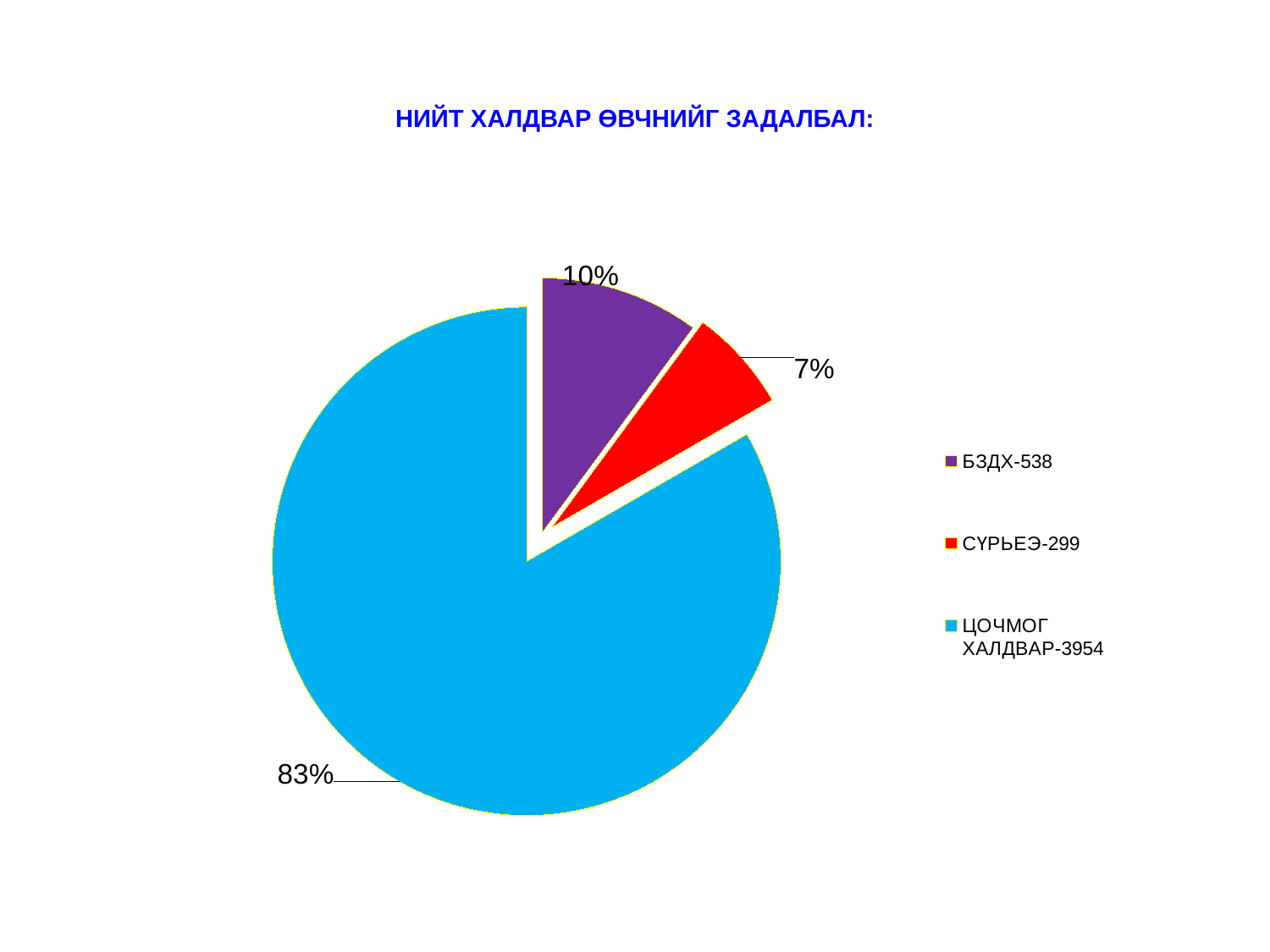
Which is larger, the share for БЗДХ-538 or the share for СҮРЬЕЭ-299? БЗДХ-538 What share of the pie does the ЦОЧМОГ ХАЛДВАР-3954 slice represent? 83% What kind of chart is shown on the slide? pie chart How many categories does the pie chart show? 3 What share of the pie does the СҮРЬЕЭ-299 slice represent? 7% What is the title of the chart? НИЙТ ХАЛДВАР ӨВЧНИЙГ ЗАДАЛБАЛ: What colour is the slice for СҮРЬЕЭ-299? red Which category has the smallest slice of the pie? СҮРЬЕЭ-299 What is the difference in percentage points between the ЦОЧМОГ ХАЛДВАР-3954 share and the БЗДХ-538 share? 73 percentage points Which category has the largest slice of the pie? ЦОЧМОГ ХАЛДВАР-3954 What is the difference in percentage points between the БЗДХ-538 share and the СҮРЬЕЭ-299 share? 3 percentage points What share of the pie does the БЗДХ-538 slice represent? 10%